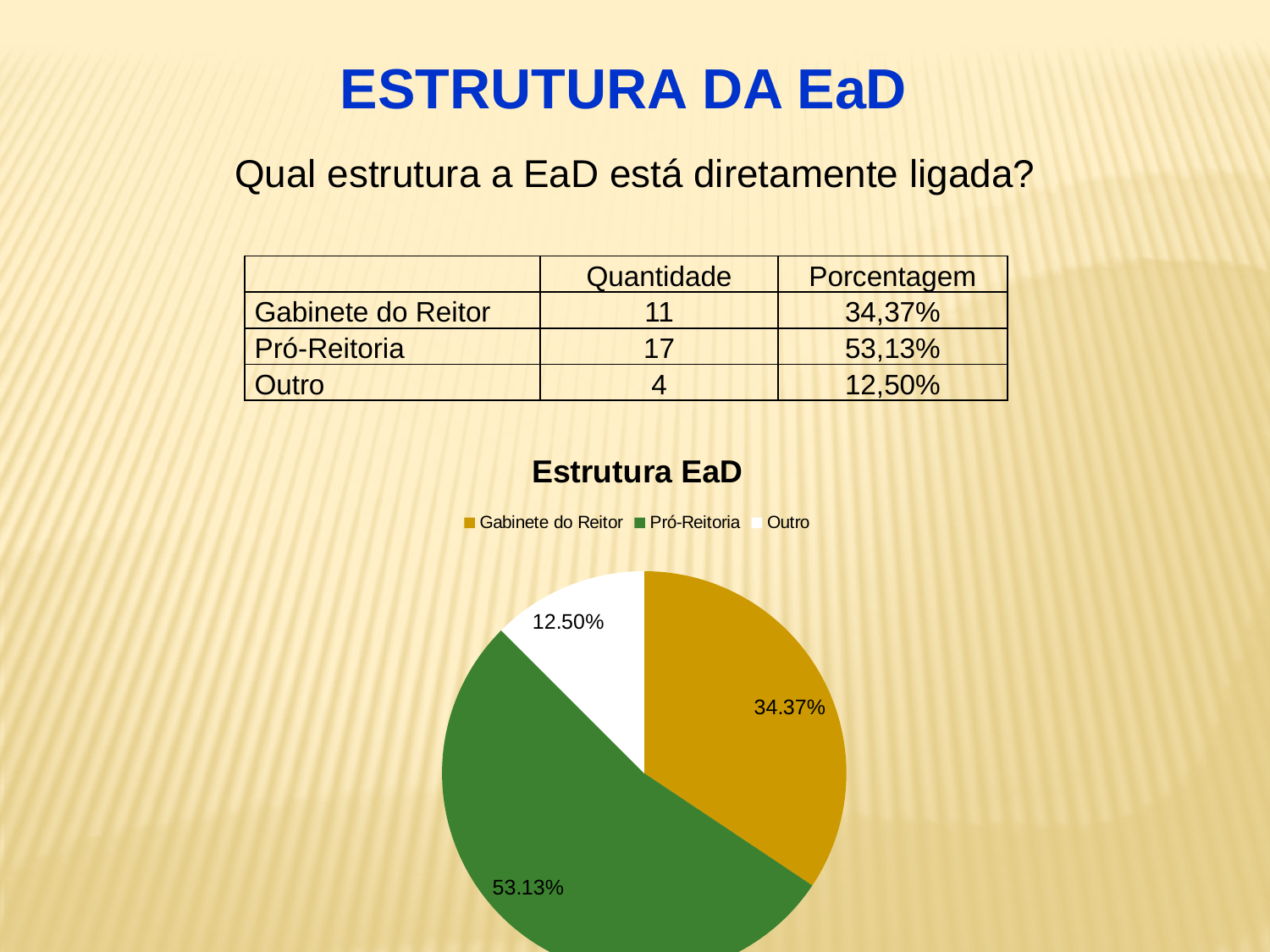
Which colour represents Pró-Reitoria in the pie chart? green Which category has the largest slice of the pie? Pró-Reitoria What share of the pie does Pró-Reitoria represent? 53.13% How many slices does the pie chart have? 3 What share of the pie does Outro represent? 12.50% Which category has the smallest slice of the pie? Outro What is the difference in percentage points between the Pró-Reitoria slice and the Gabinete do Reitor slice? 18.76% What share of the pie does Gabinete do Reitor represent? 34.37% Which slice is larger, Gabinete do Reitor or Outro? Gabinete do Reitor What kind of chart is shown on the slide? pie chart What is the title of the chart? Estrutura EaD How many entries does the chart legend list? 3